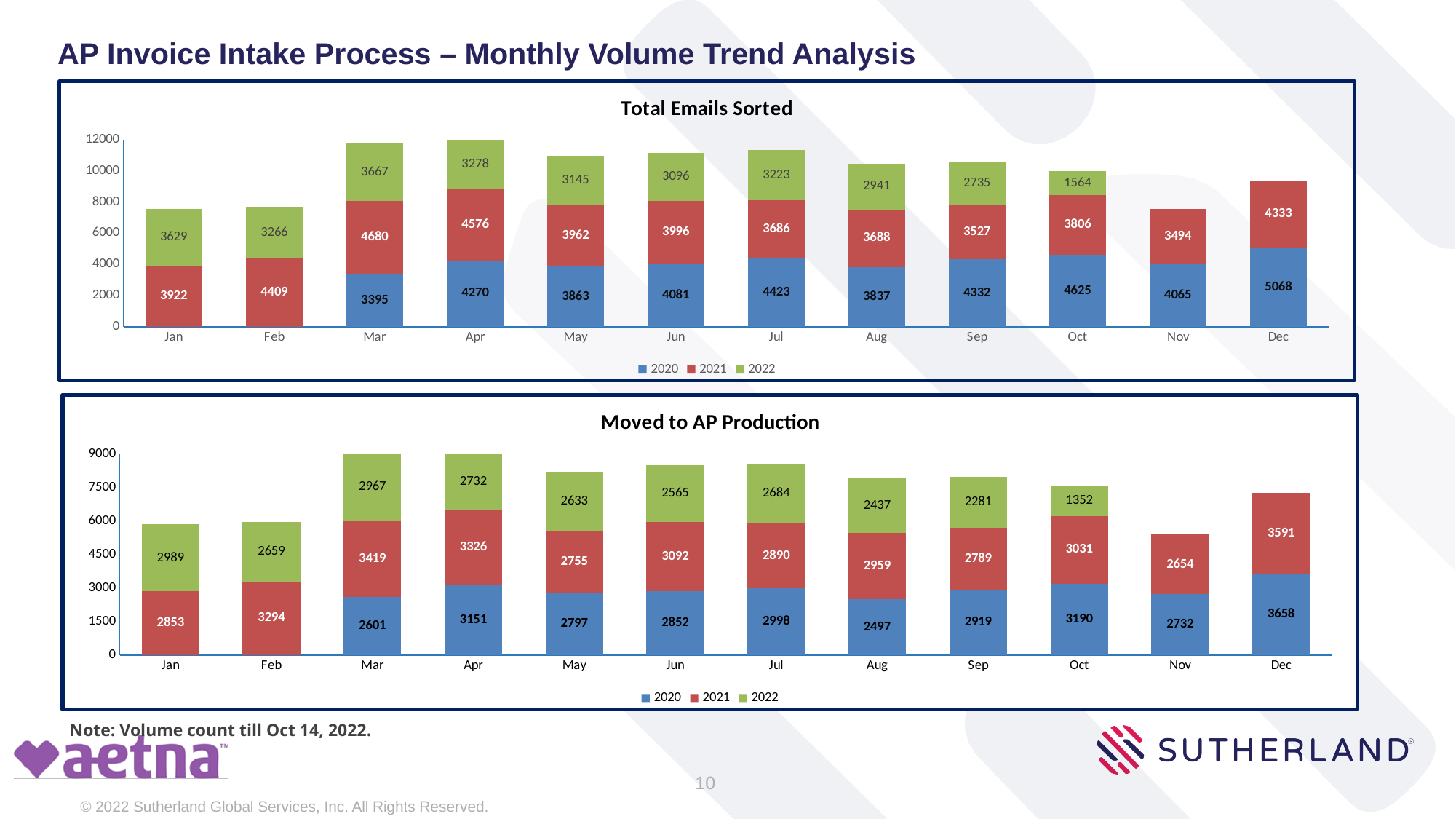
In the Total Emails Sorted chart, what is the 2022 value for October? 1564 In the Moved to AP Production chart, which month has the lowest 2022 value? Oct What type of chart is the Moved to AP Production chart? Stacked bar chart In the Total Emails Sorted chart, what is the total height of the stacked bar for January? 7551 In the Moved to AP Production chart, what is the total height of the stacked bar for January? 5842 In the Total Emails Sorted chart, what is the difference between the 2020 and 2021 values for December? 735 In the Moved to AP Production chart, which is larger for February: the 2021 value or the 2022 value? 2021 In the Total Emails Sorted chart, which month has the highest 2020 value? Dec In the Moved to AP Production chart, what is the 2020 value for July? 2998 In the Total Emails Sorted chart, what is the 2021 value for March? 4680 How many months are shown on the x axis of the Moved to AP Production chart? 12 How many series does the legend of the Total Emails Sorted chart list? 3